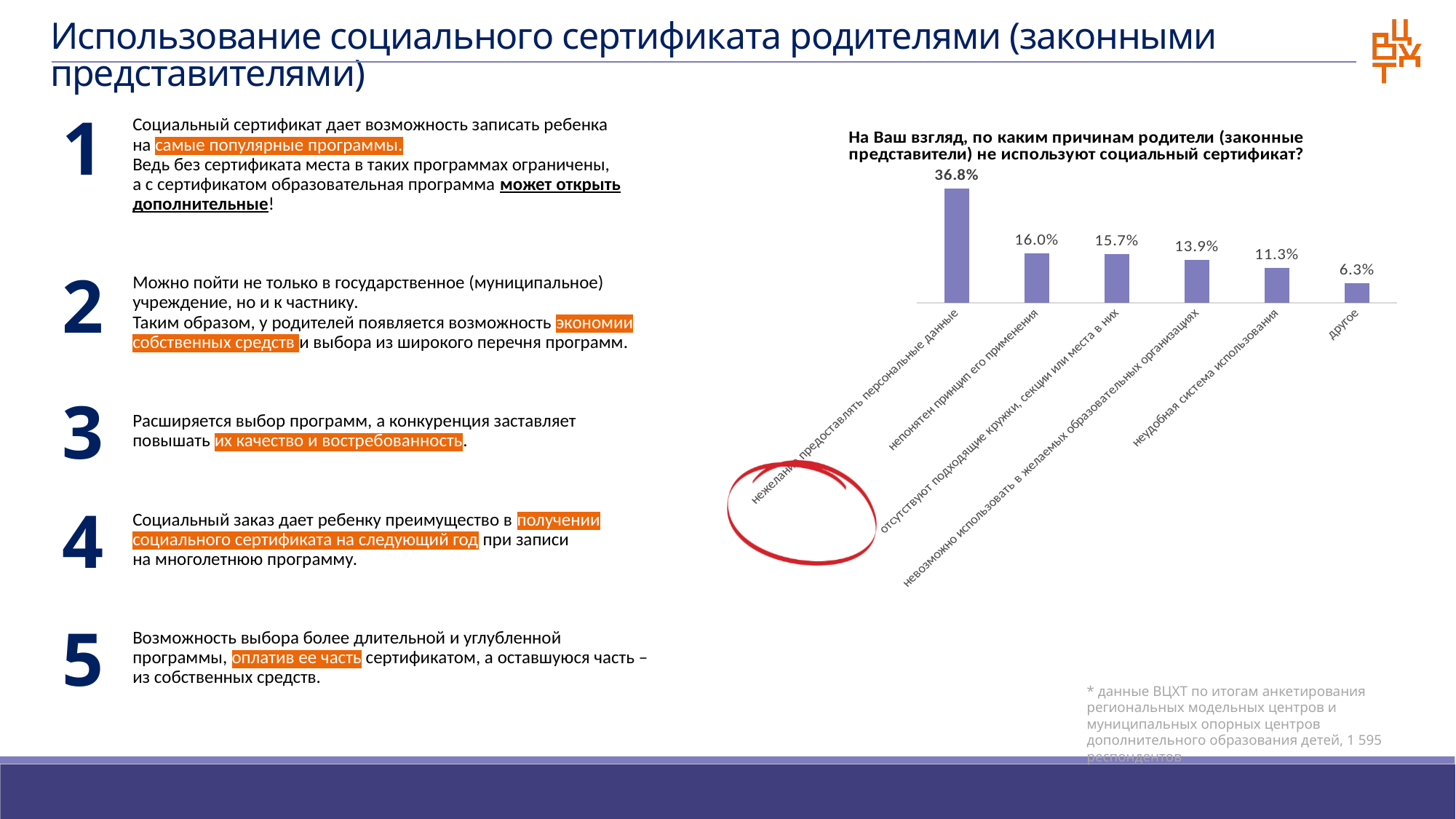
What is the value for "нежелание предоставлять персональные данные"? 36.8% What is the value for "неудобная система использования"? 11.3% What is the value for "непонятен принцип его применения"? 16.0% Which is larger: the value for "невозможно использовать в желаемых образовательных организациях" or the value for "неудобная система использования"? невозможно использовать в желаемых образовательных организациях What is the title of the chart? На Ваш взгляд, по каким причинам родители (законные представители) не используют социальный сертификат? How many categories (reasons) are plotted in the chart? 6 What is the difference between the values for "нежелание предоставлять персональные данные" and "непонятен принцип его применения"? 20.8% Do the values rise or fall from left to right along the x axis? fall What type of chart is shown on the slide? bar chart What is the value for "другое"? 6.3% Which category has the lowest value in the chart? другое Which category has the highest value in the chart? нежелание предоставлять персональные данные